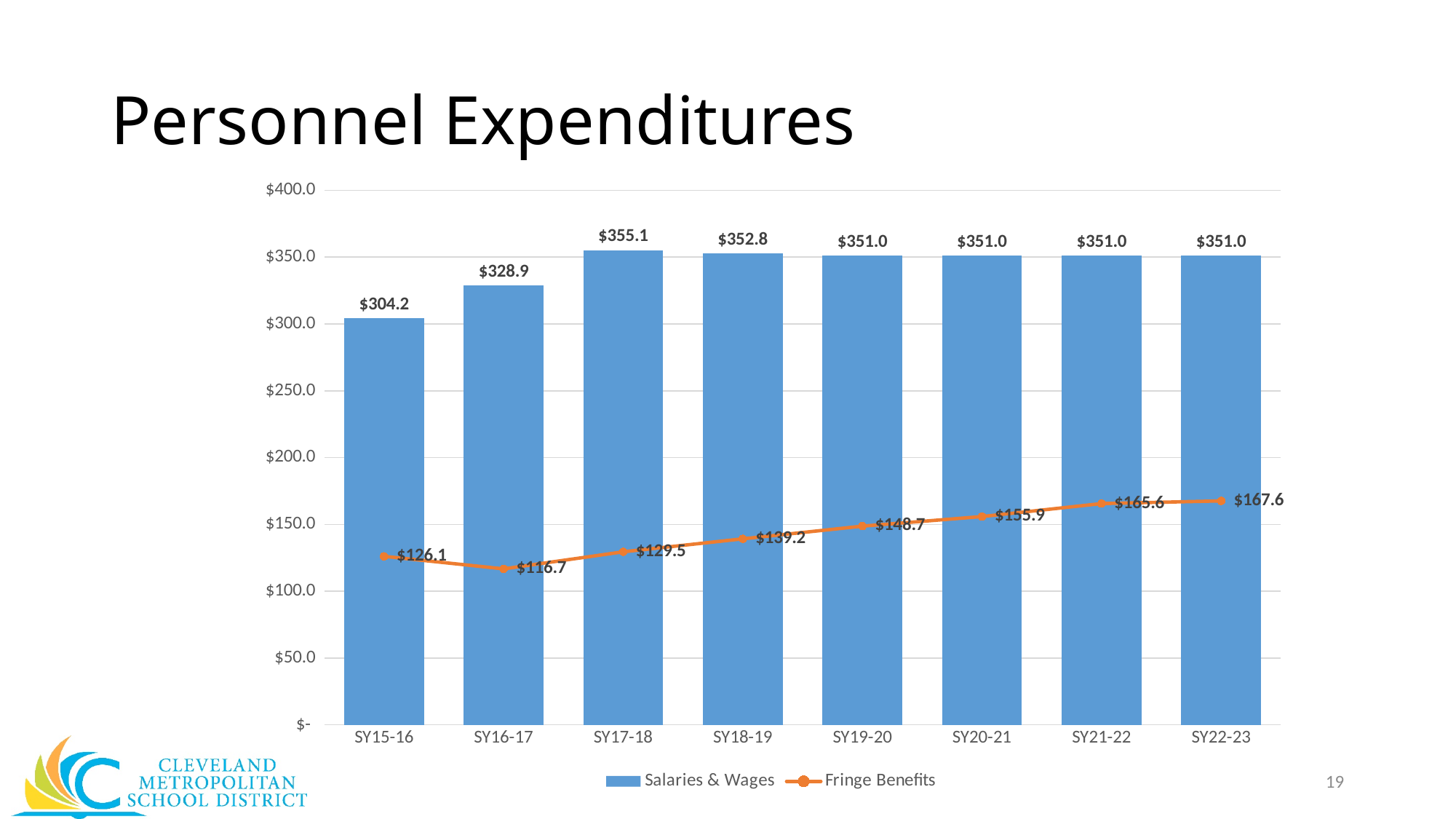
How many series does the legend list? 2 Do the Fringe Benefits values rise or fall from SY16-17 to SY22-23? Rise What is the Salaries & Wages value for SY16-17? $328.9 What kind of chart is used for the Salaries & Wages series? Bar chart What is the Fringe Benefits value for SY19-20? $148.7 Which is larger, the Fringe Benefits value for SY15-16 or for SY16-17? SY15-16 Which school year has the lowest Fringe Benefits value? SY16-17 How many school years are shown on the x axis? 8 Which school year has the highest Salaries & Wages value? SY17-18 Is the Fringe Benefits value for SY22-23 greater or less than $150.0? greater What is the title of the chart? Personnel Expenditures What is the difference between the Salaries & Wages values for SY17-18 and SY15-16? $50.9